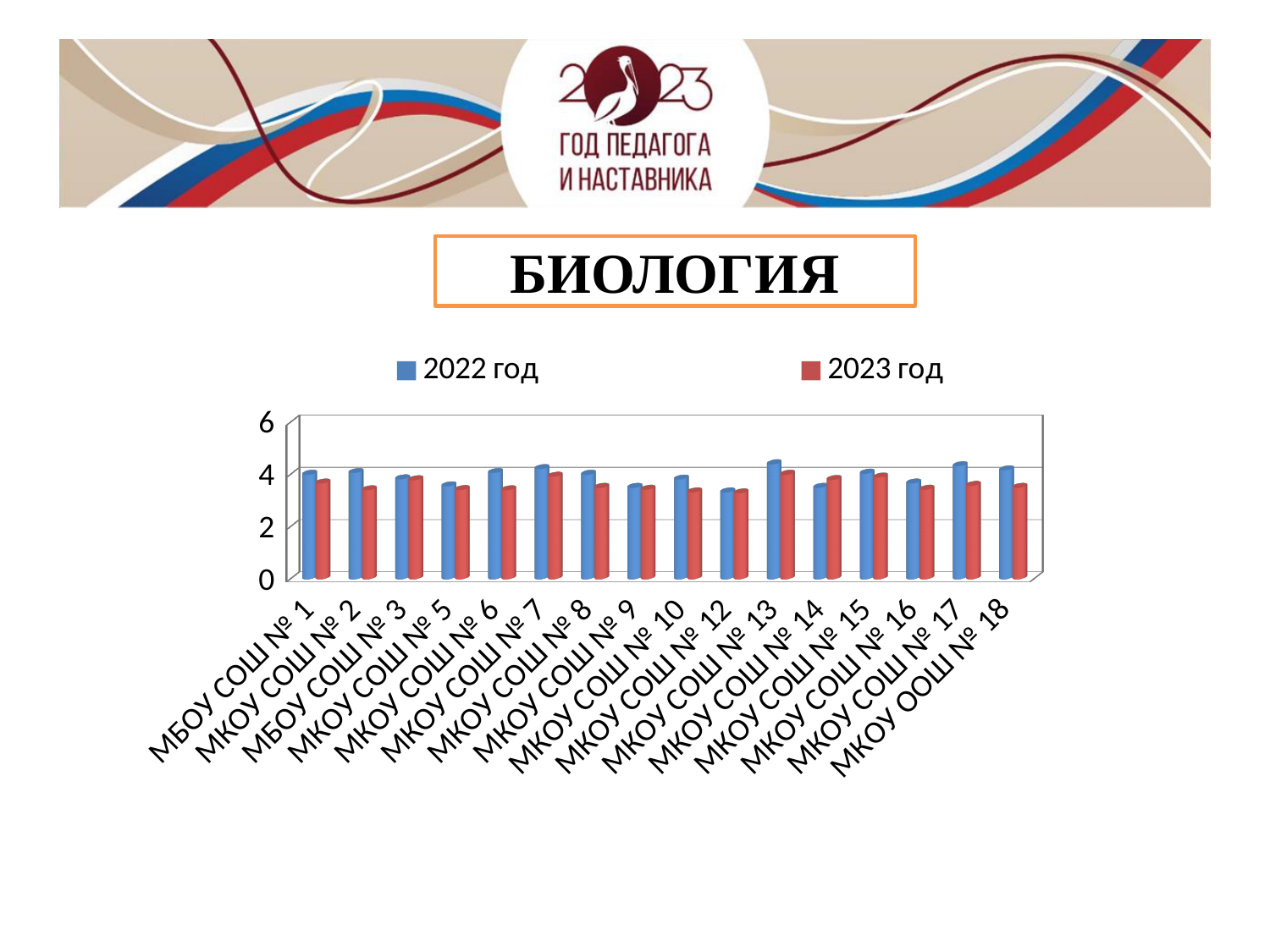
Is the 2022 год value for МБОУ СОШ № 1 greater or less than 2? greater For МКОУ СОШ № 13, which series has the larger value, 2022 год or 2023 год? 2022 год What is the title shown above the chart? БИОЛОГИЯ How many schools (categories) are shown on the x axis of the chart? 16 Is the 2022 год value for МКОУ СОШ № 13 greater or less than 4? greater For МКОУ СОШ № 17, which series has the larger value, 2022 год or 2023 год? 2022 год Is the 2023 год value for МКОУ СОШ № 10 greater or less than 4? less Which colour represents the series "2023 год" in the chart? red For МКОУ СОШ № 14, which series has the larger value, 2022 год or 2023 год? 2023 год What kind of chart is shown on the slide? bar chart How many series does the chart legend list? 2